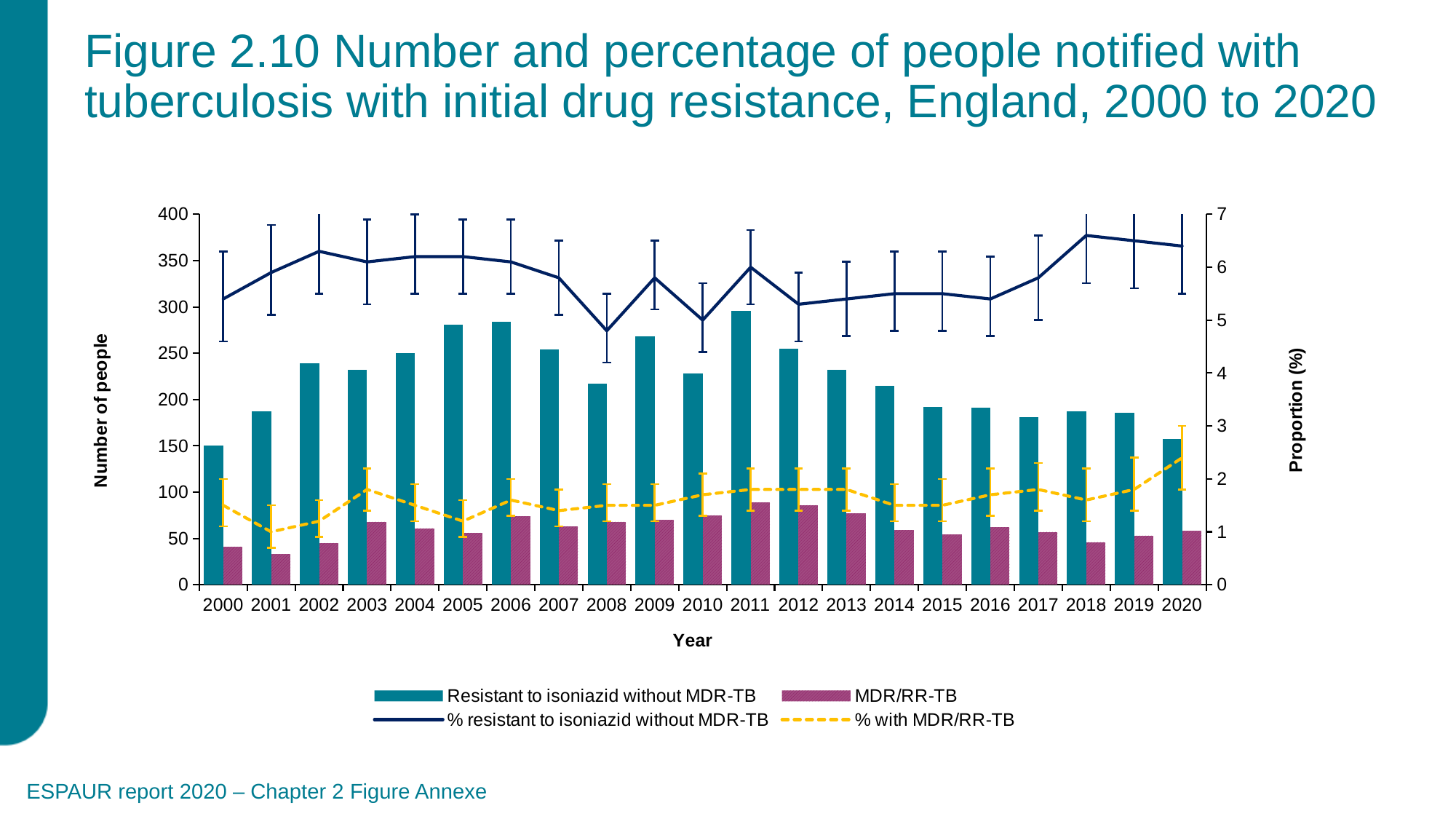
In which year is the bar for 'Resistant to isoniazid without MDR-TB' the tallest? 2011 What kind of chart is shown on the slide? A combined bar and line chart Is the number of people with MDR/RR-TB in 2001 greater or less than 50? less How many series does the legend list? 4 How many years are shown along the x axis? 21 What is the title of the right-hand vertical axis? Proportion (%) In which year is the bar for 'MDR/RR-TB' the lowest? 2001 Is the '% resistant to isoniazid without MDR-TB' value in 2008 greater or less than 5? less Is the number of people resistant to isoniazid without MDR-TB in 2008 greater or less than 250? less Which year has the taller 'Resistant to isoniazid without MDR-TB' bar, 2001 or 2002? 2002 Do the 'Resistant to isoniazid without MDR-TB' bars generally rise or fall from 2011 to 2020? fall